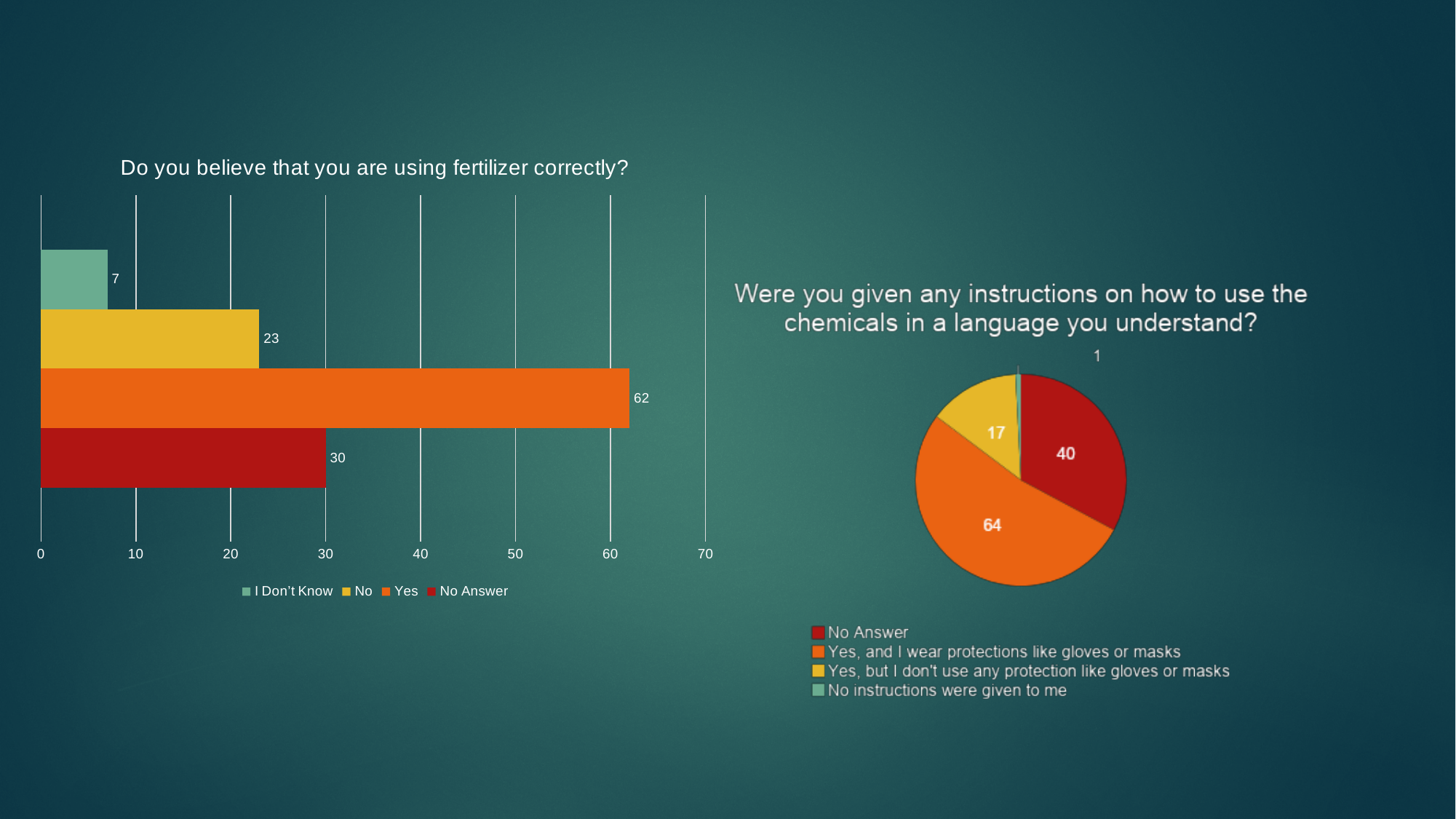
In the chart titled 'Do you believe that you are using fertilizer correctly?', what is the difference between the values for 'Yes' and 'No'? 39 In the chart titled 'Do you believe that you are using fertilizer correctly?', how many entries does the legend list? 4 In the chart titled 'Do you believe that you are using fertilizer correctly?', which category has the lowest value? I Don't Know In the pie chart on the right, what is the difference between the values for 'No Answer' and 'Yes, but I don't use any protection like gloves or masks'? 23 In the chart titled 'Do you believe that you are using fertilizer correctly?', what is the value for 'Yes'? 62 In the pie chart on the right, which category has the largest slice? Yes, and I wear protections like gloves or masks In the chart titled 'Do you believe that you are using fertilizer correctly?', what kind of chart is shown? Bar chart In the pie chart on the right, which is larger: 'No Answer' or 'Yes, but I don't use any protection like gloves or masks'? No Answer In the pie chart on the right, what is the value for 'No instructions were given to me'? 1 In the chart titled 'Do you believe that you are using fertilizer correctly?', what is the value for 'No Answer'? 30 In the pie chart on the right, what is the value for 'Yes, and I wear protections like gloves or masks'? 64 In the chart titled 'Do you believe that you are using fertilizer correctly?', is the value for 'No' greater or less than 20? greater